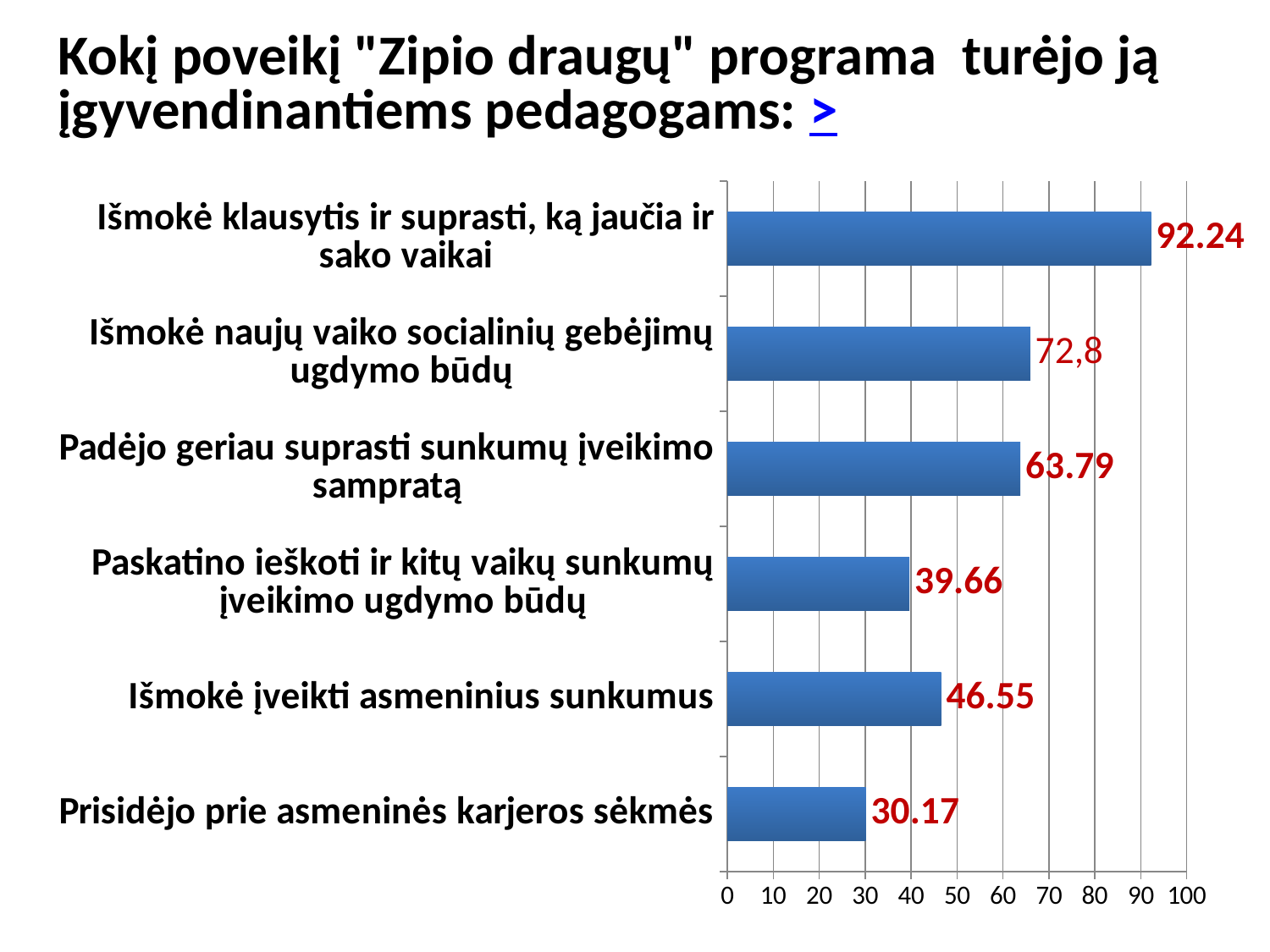
What value is shown for "Išmokė klausytis ir suprasti, ką jaučia ir sako vaikai"? 92.24 What kind of chart is shown on the slide? bar chart What value is shown for "Padėjo geriau suprasti sunkumų įveikimo sampratą"? 63.79 Which is larger: the value for "Išmokė įveikti asmeninius sunkumus" or for "Paskatino ieškoti ir kitų vaikų sunkumų įveikimo ugdymo būdų"? Išmokė įveikti asmeninius sunkumus What value is shown for "Išmokė įveikti asmeninius sunkumus"? 46.55 What is the difference between the values for "Išmokė klausytis ir suprasti, ką jaučia ir sako vaikai" and "Prisidėjo prie asmeninės karjeros sėkmės"? 62.07 Which category has the lowest value? Prisidėjo prie asmeninės karjeros sėkmės What is the maximum value shown on the horizontal axis? 100 Which category has the highest value? Išmokė klausytis ir suprasti, ką jaučia ir sako vaikai Is the value for "Padėjo geriau suprasti sunkumų įveikimo sampratą" greater or less than 60? greater What value is shown for "Prisidėjo prie asmeninės karjeros sėkmės"? 30.17 How many categories are shown in the chart? 6